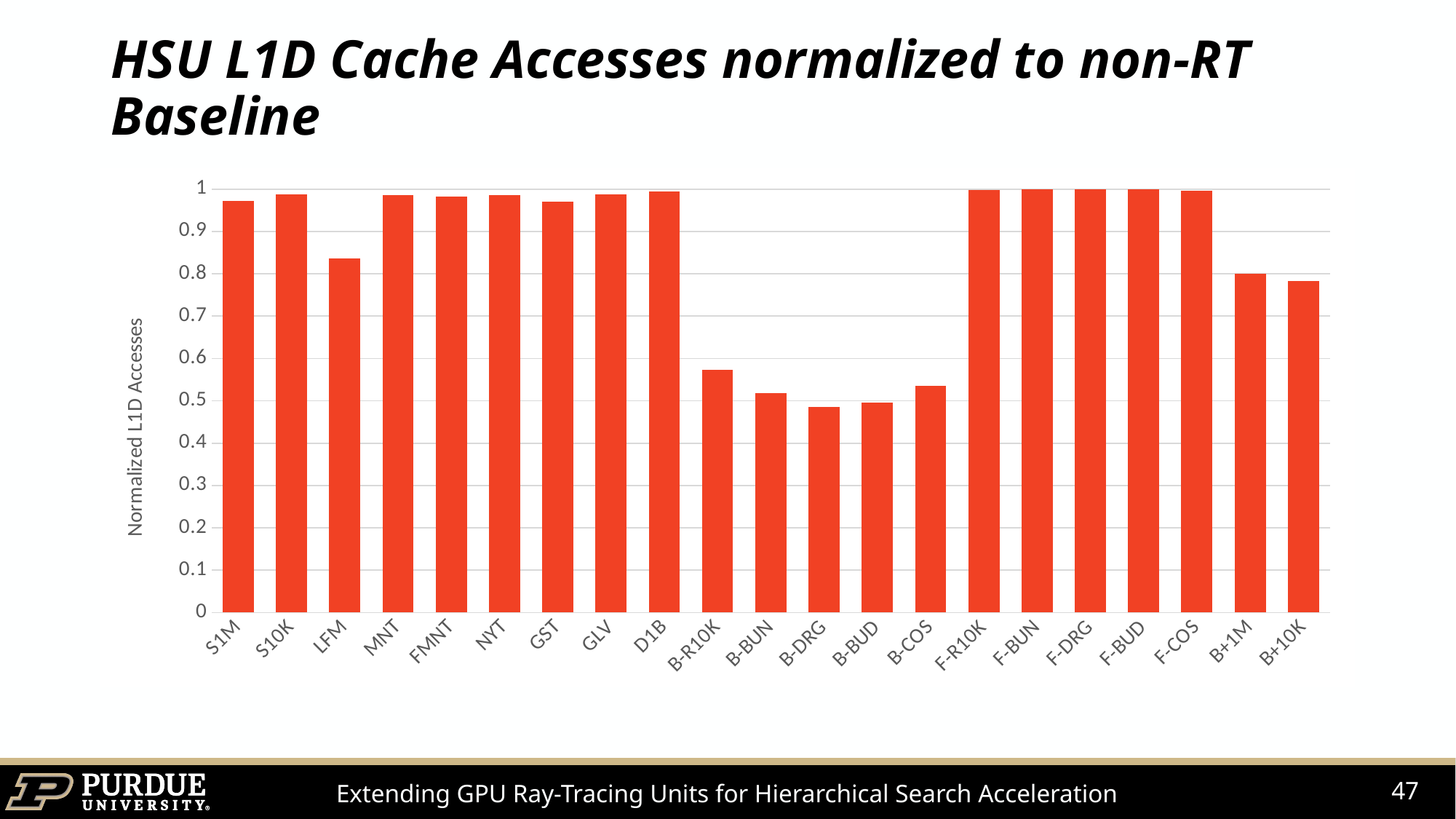
Is the value for F-COS greater or less than 0.9? greater Is the value for B-COS greater or less than 0.6? less What is the title of the chart? HSU L1D Cache Accesses normalized to non-RT Baseline What kind of chart is shown on the slide? bar chart Which has the larger value, S1M or B+1M? S1M Is the value for LFM greater or less than 0.8? greater What is the label on the vertical axis? Normalized L1D Accesses Which has the larger value, LFM or B-R10K? LFM Which has the larger value, B-COS or B-BUD? B-COS How many categories are plotted along the x axis? 21